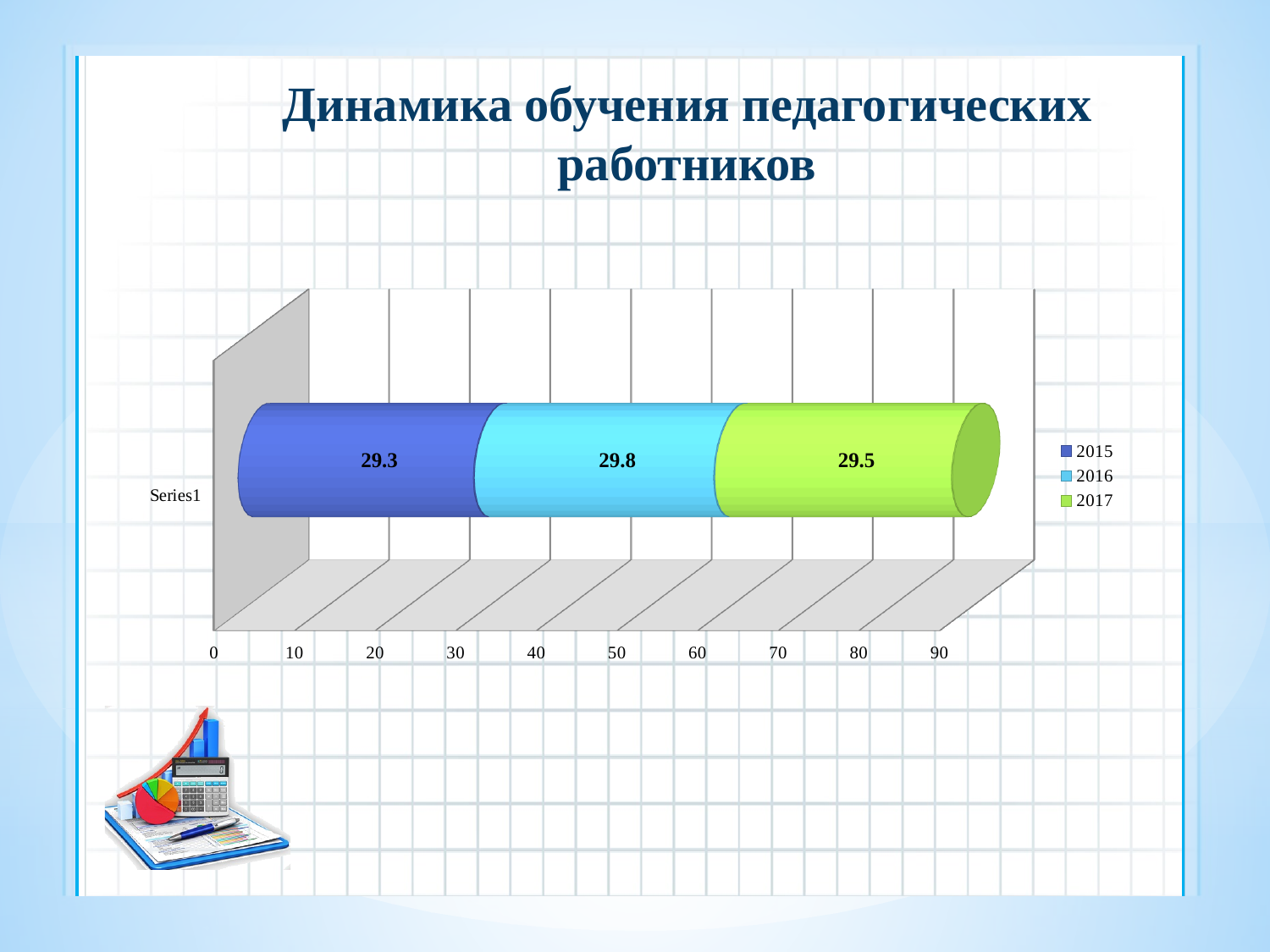
How many series does the legend list? 3 What is the value for 2016 in the stacked bar? 29.8 What is the title of the chart? Динамика обучения педагогических работников What is the value for 2015 in the stacked bar? 29.3 What is the difference between the values for 2016 and 2015? 0.5 What is the difference between the values for 2016 and 2017? 0.3 What is the value for 2017 in the stacked bar? 29.5 Which year has the highest value? 2016 What kind of chart is shown on the slide? Stacked bar chart Which is larger, the value for 2017 or the value for 2015? 2017 Which year has the lowest value? 2015 What is the total of the stacked bar for Series1? 88.6